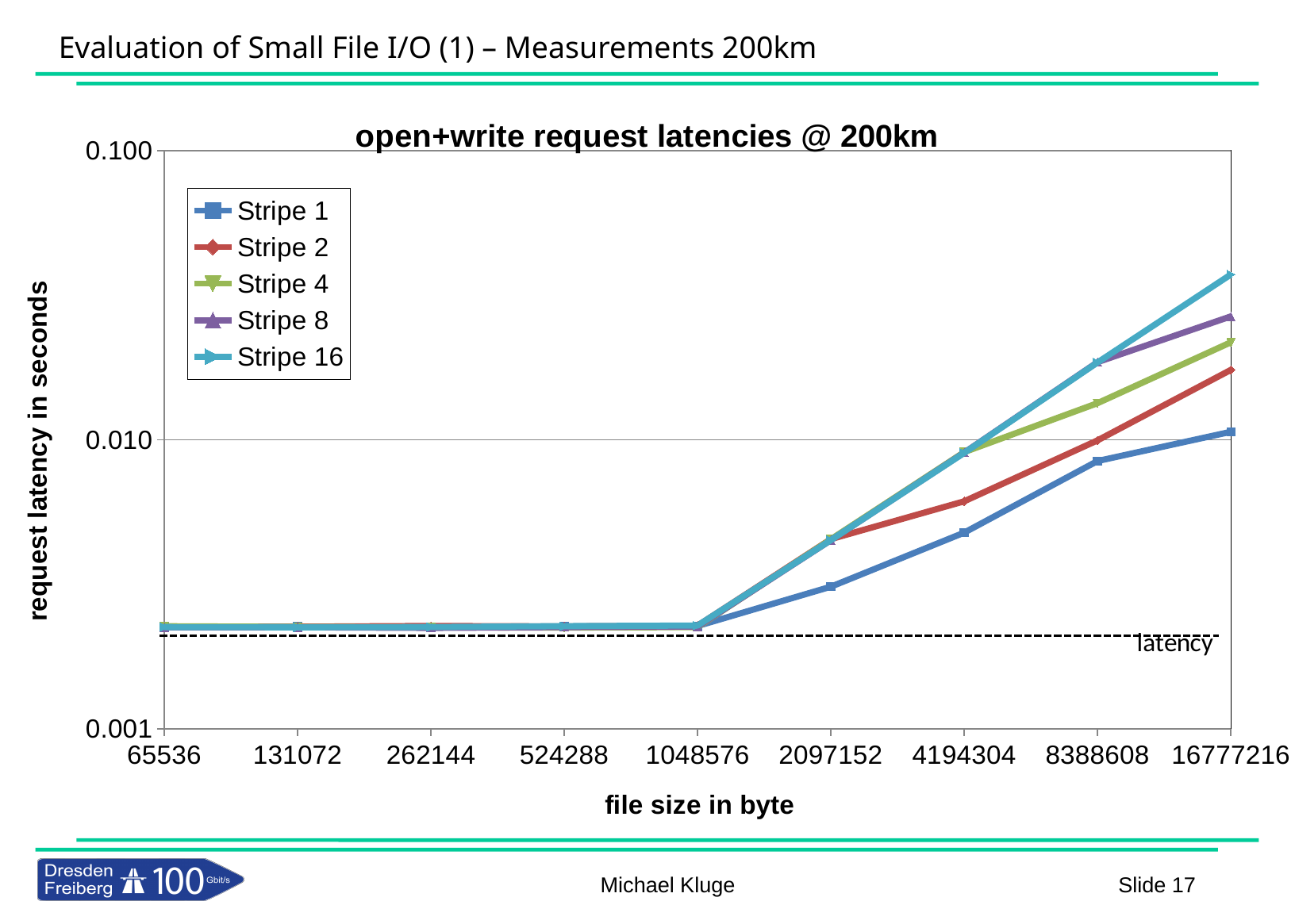
Which series has the highest request latency at file size 16777216? Stripe 16 Which series has the lowest request latency at file size 16777216? Stripe 1 How many series does the legend list? 5 Is the request latency for Stripe 16 at file size 16777216 greater or less than 0.010 seconds? greater How many file size values are shown along the x axis? 9 What is the label of the y axis? request latency in seconds Is the request latency for Stripe 1 at file size 2097152 greater or less than 0.010 seconds? less At file size 16777216, which has the higher request latency, Stripe 8 or Stripe 4? Stripe 8 What is the title of the chart? open+write request latencies @ 200km Is the request latency for Stripe 2 at file size 4194304 greater or less than 0.010 seconds? less Do the request latencies rise or fall as file size increases from 1048576 to 16777216? rise What kind of chart is shown on the slide? line chart